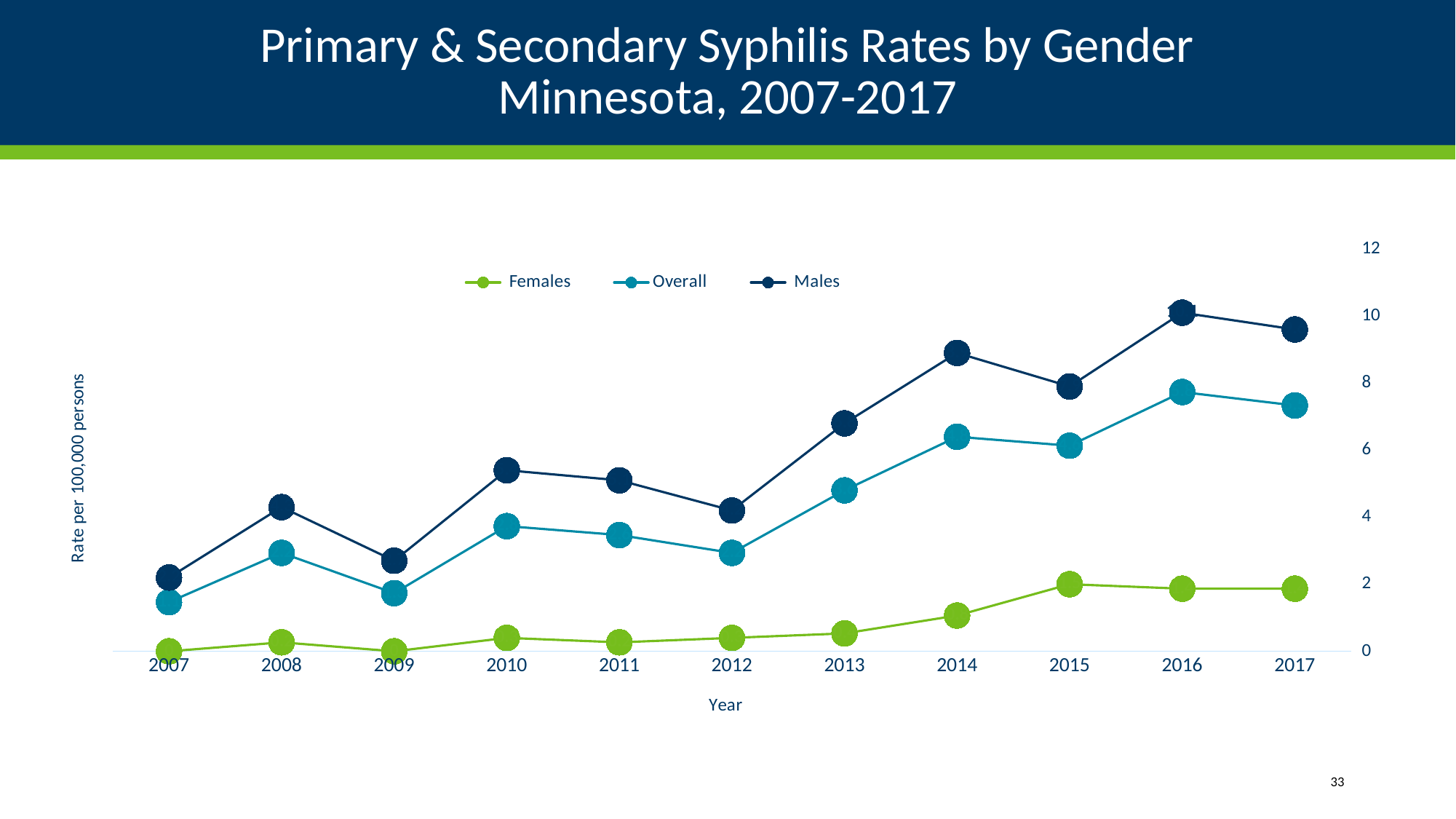
Does the Males rate rise or fall from 2012 to 2014? rise In which year is the Males rate lowest? 2007 Is the Females rate for 2014 greater or less than 2? less Is the Males rate for 2014 greater or less than 8? greater Which is larger in 2017, the Males rate or the Females rate? Males How many years are plotted along the x axis? 11 Is the Overall rate for 2016 greater or less than 8? less In which year is the Males rate highest? 2016 What kind of chart is shown on the slide? line chart How many series does the legend list? 3 In which year is the Overall rate highest? 2016